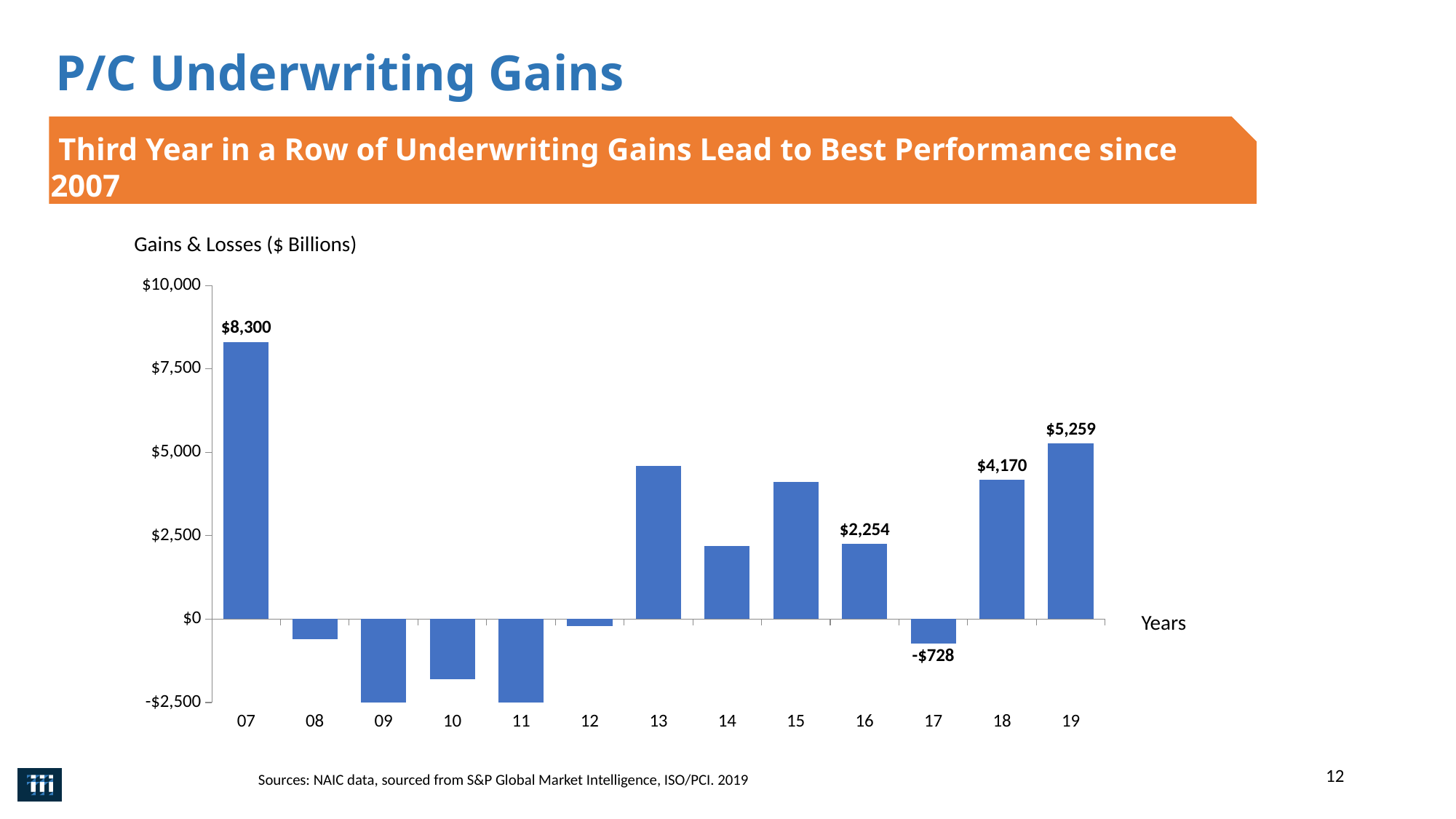
What kind of chart is shown on the slide? bar chart Is the value for 13 greater or less than $2,500? greater What is the value for 19? $5,259 What is the value for 07? $8,300 What is the value for 16? $2,254 What is the value for 18? $4,170 How many years are shown on the x axis? 13 What is the value for 17? -$728 What is the label on the vertical axis of the chart? Gains & Losses ($ Billions) Which year has the highest value? 07 Which is larger, the value for 18 or the value for 16? 18 What is the difference between the values for 19 and 18? $1,089